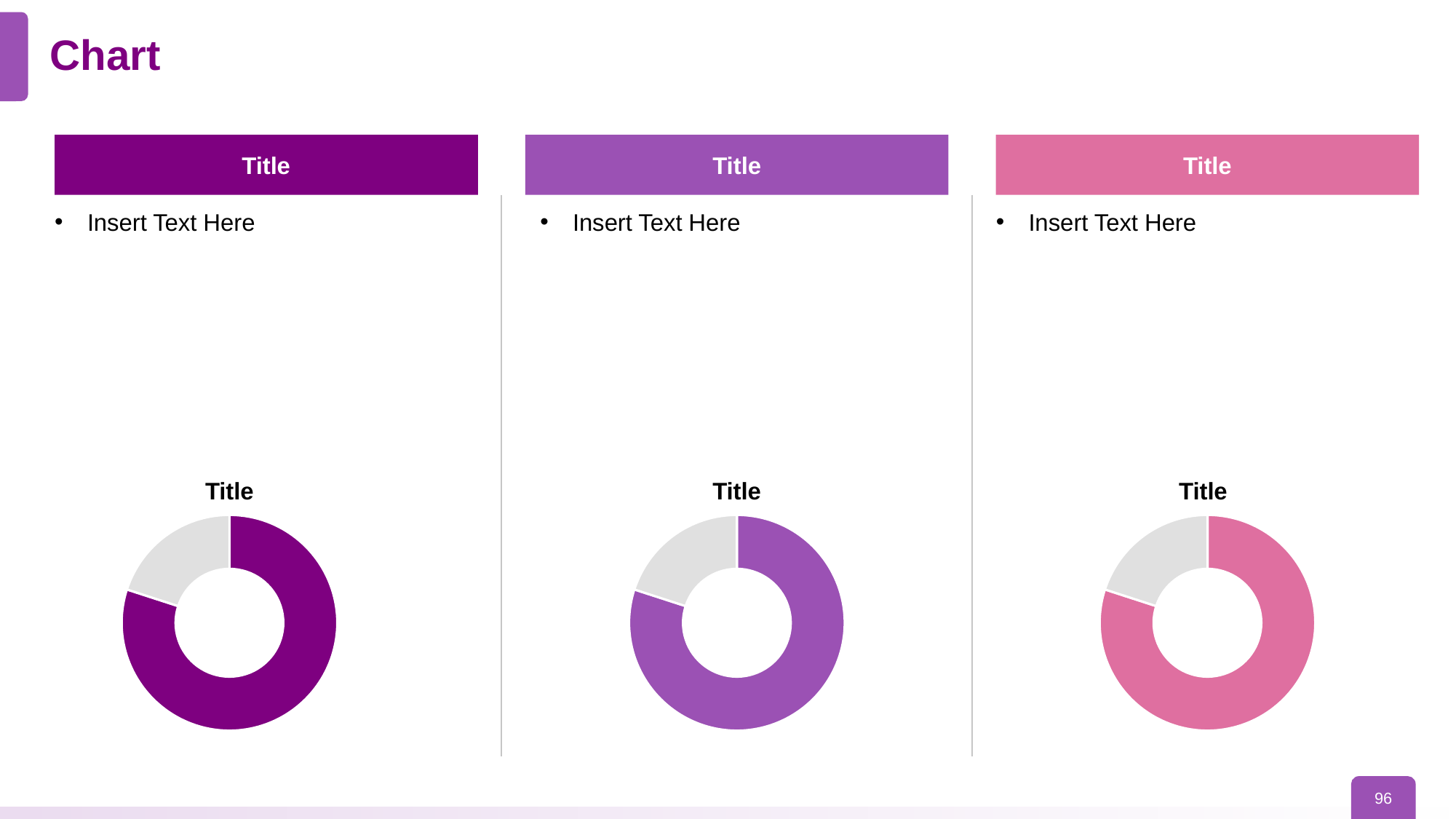
What kind of chart is the right chart on the slide? Doughnut chart How many slices does the left doughnut chart have? 2 What kind of chart is the middle chart on the slide? Doughnut chart In the middle doughnut chart, which slice is larger, the purple slice or the grey slice? The purple slice In the right doughnut chart, which slice is larger, the pink slice or the grey slice? The pink slice In the left doughnut chart, which slice is larger, the purple slice or the grey slice? The purple slice How many slices does the right doughnut chart have? 2 How many doughnut charts are shown on the slide? 3 What is the title shown above the left doughnut chart? Title What kind of chart is the left chart on the slide? Doughnut chart What colour is the larger slice of the right doughnut chart? Pink